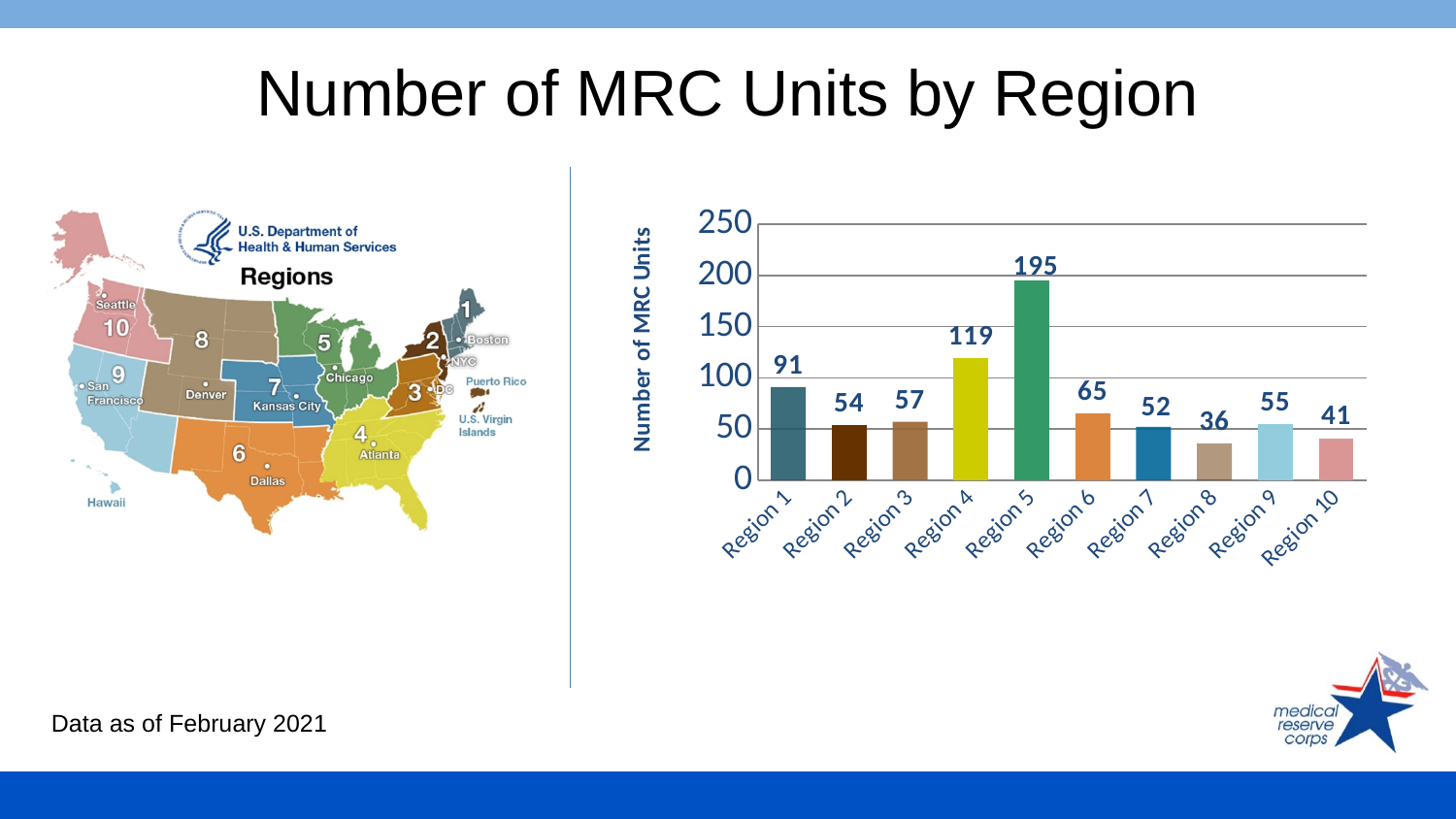
Is the value for Region 4 greater or less than 100? greater What kind of chart is used to show the number of MRC units by region? Bar chart What is the value shown for Region 8? 36 What is the difference in MRC units between Region 5 and Region 4? 76 Which has more MRC units, Region 6 or Region 7? Region 6 How many more MRC units does Region 1 have than Region 10? 50 How many MRC units does Region 5 have? 195 Which region has the highest number of MRC units? Region 5 What is the label of the vertical axis of the chart? Number of MRC Units What is the number of MRC units for Region 4? 119 How many regions are shown on the chart? 10 Which region has the lowest number of MRC units? Region 8